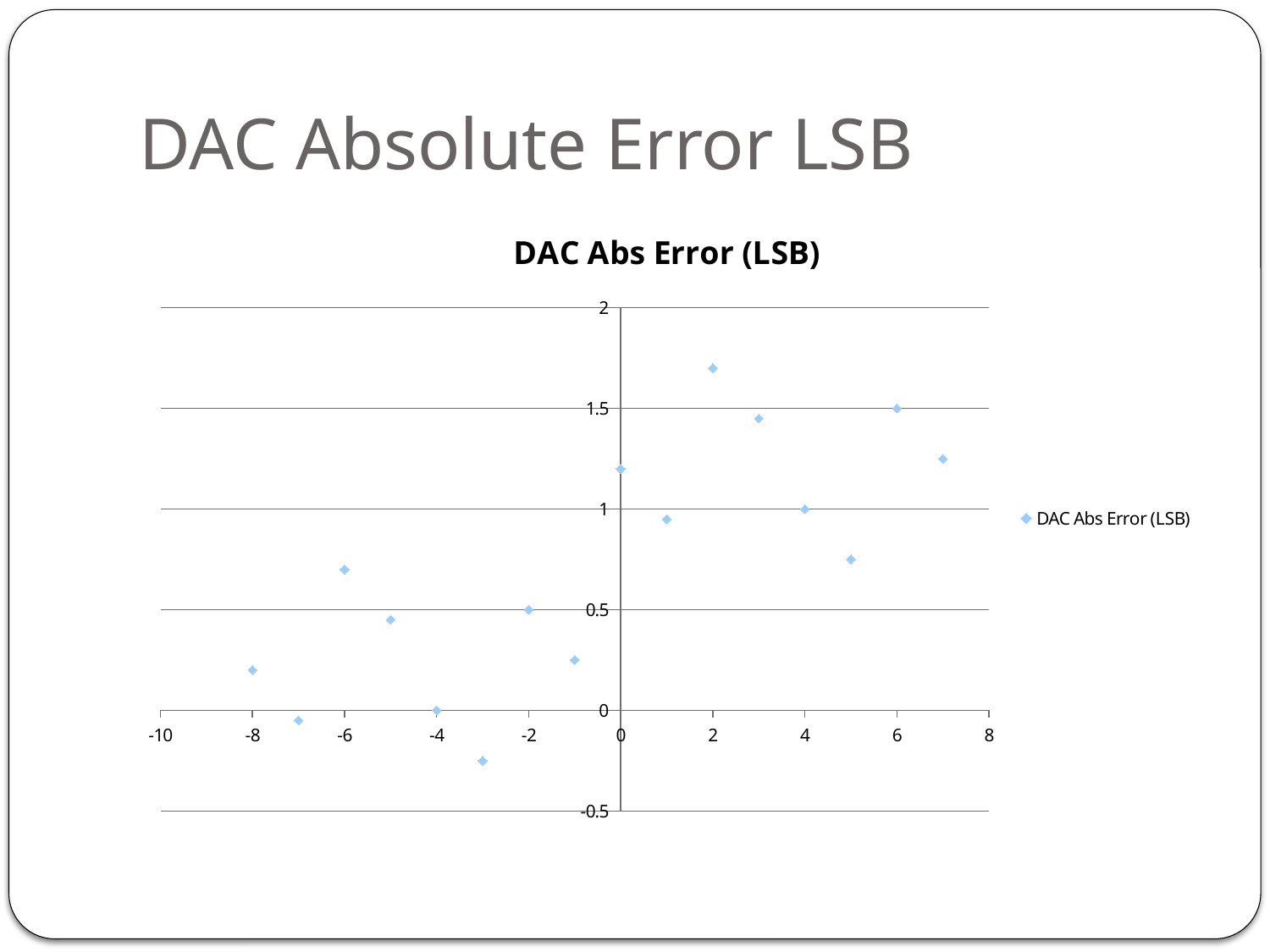
What is the title of the chart? DAC Abs Error (LSB) At which x value is the DAC Abs Error lowest? -3 How many series does the legend list? 1 At which x value is the DAC Abs Error highest? 2 Is the DAC Abs Error value at x = -6 greater or less than 0.5? greater What is the DAC Abs Error value at x = -4? 0 Is the DAC Abs Error value at x = 5 greater or less than 1? less What is the DAC Abs Error value at x = 6? 1.5 What kind of chart is shown on the slide? Scatter chart How many data points are plotted in the chart? 16 Which has the larger DAC Abs Error value, x = 2 or x = 3? x = 2 Is the DAC Abs Error value at x = -8 greater or less than 0.5? less